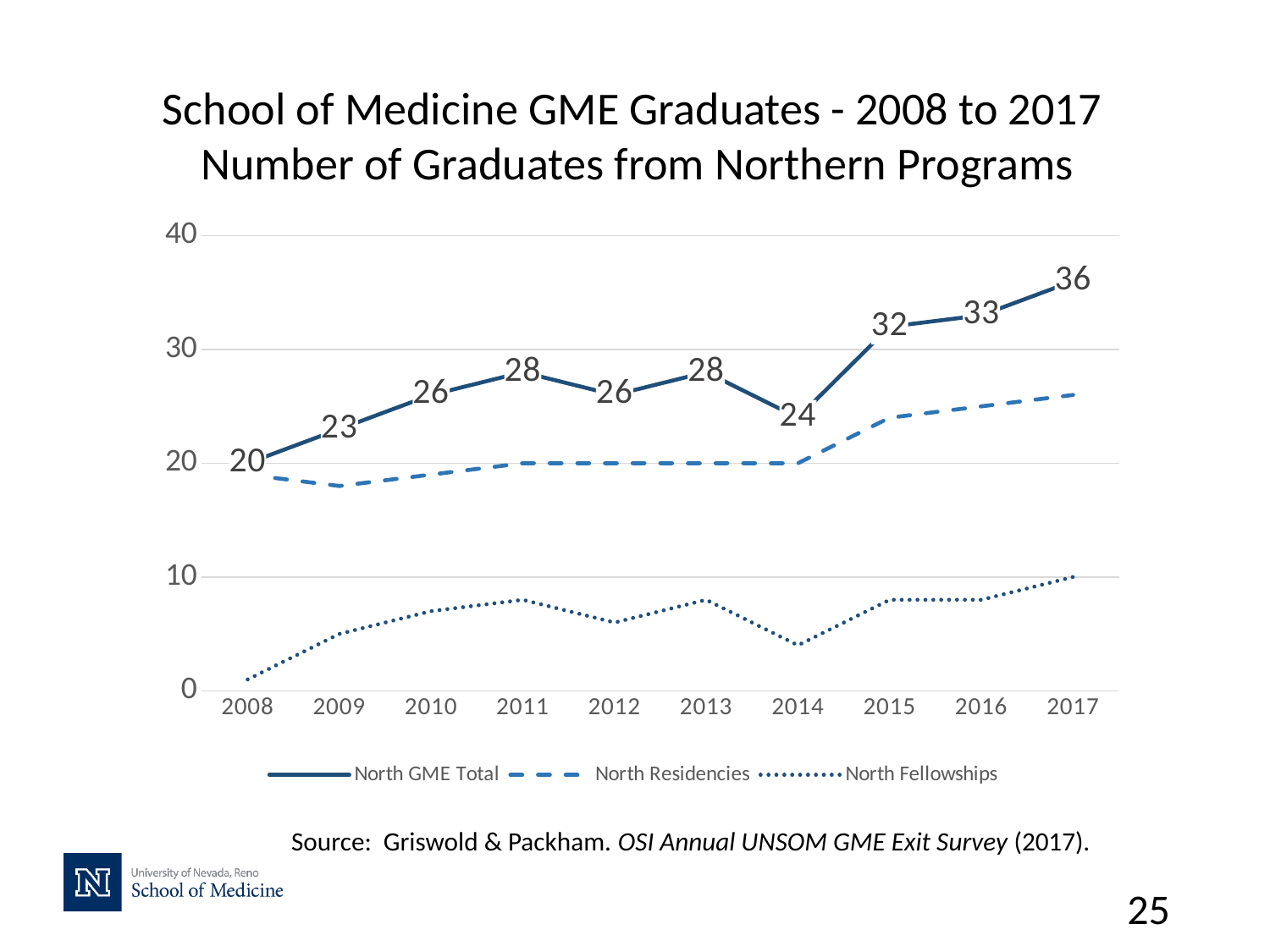
Is the North Residencies value for 2009 greater or less than 20? less What is the difference between the North GME Total in 2017 and in 2008? 16 In which year is the North GME Total lowest? 2008 How many series does the legend list? 3 Is the North Fellowships value for 2014 greater or less than 10? less How many years are shown on the x axis? 10 In which year is the North GME Total highest? 2017 What is the North GME Total value for 2008? 20 What kind of chart is shown on the slide? Line chart What is the North GME Total value for 2017? 36 What is the North GME Total value for 2014? 24 Which year has a larger North GME Total, 2013 or 2014? 2013